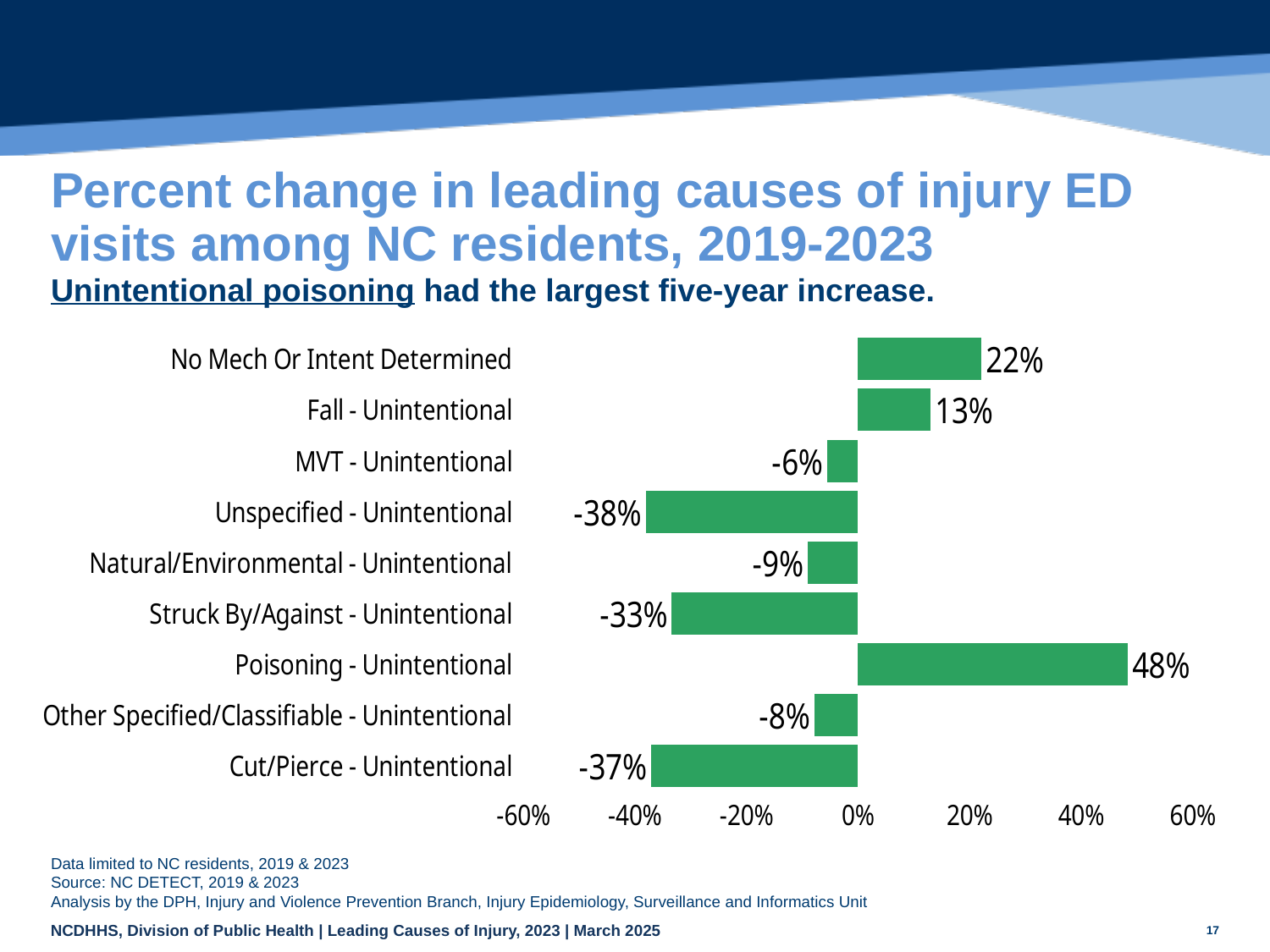
What is the difference between the percent change for Poisoning - Unintentional and No Mech Or Intent Determined? 26 percentage points Which category has the lowest percent change? Unspecified - Unintentional What is the percent change for Poisoning - Unintentional? 48% What kind of chart is shown on the slide? Bar chart Which category has the highest percent change? Poisoning - Unintentional Which has a larger percent change, Fall - Unintentional or MVT - Unintentional? Fall - Unintentional How many categories show a negative percent change? 6 How many categories are shown in the chart? 9 What is the percent change for Fall - Unintentional? 13% Is the value for Struck By/Against - Unintentional greater or less than -20%? less What is the percent change for Cut/Pierce - Unintentional? -37% What is the percent change for Natural/Environmental - Unintentional? -9%